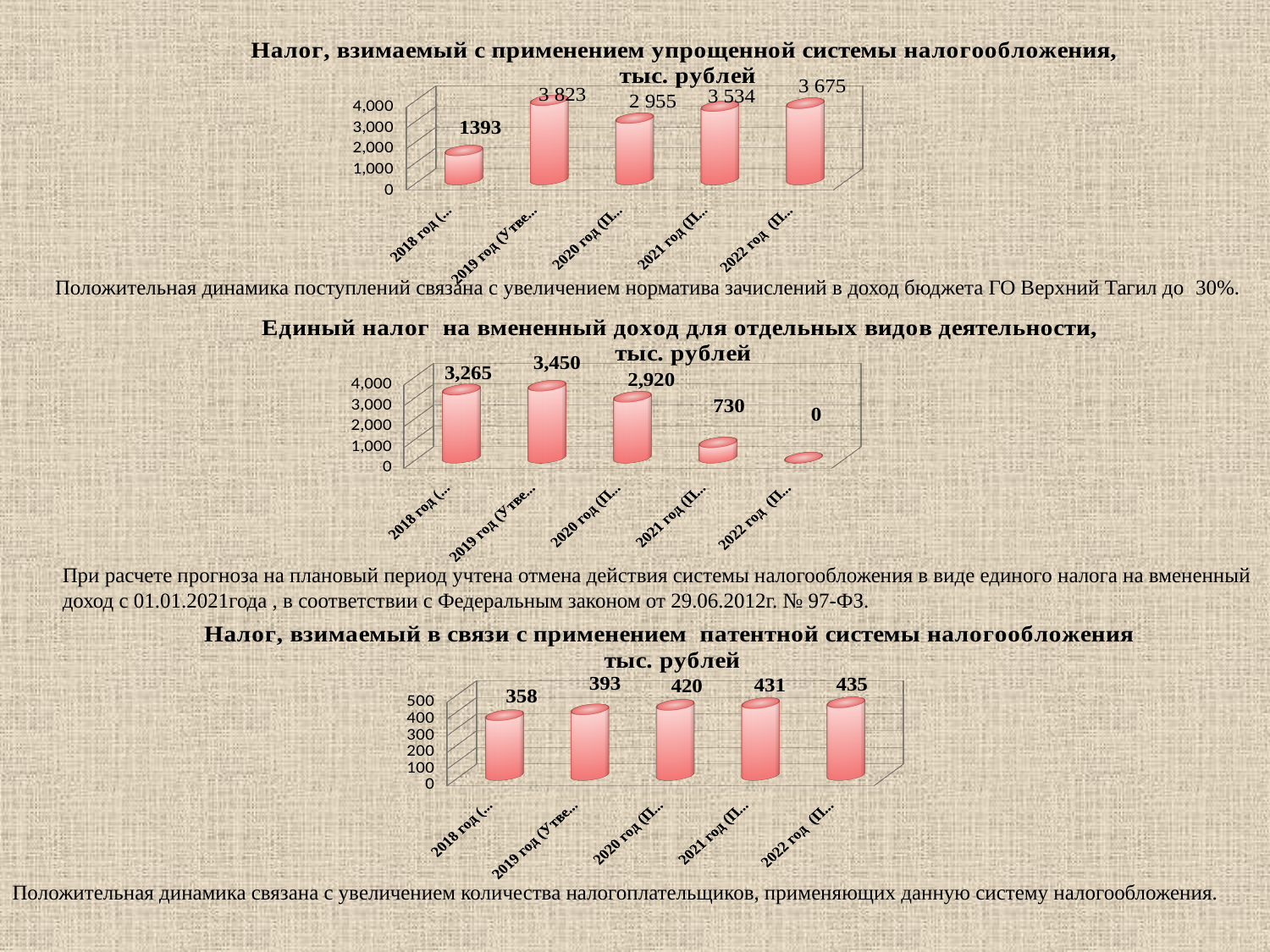
In the bottom chart (патентной системы налогообложения), what is the difference between the values for 2022 год and 2018 год? 77 In the top chart (упрощенной системы налогообложения), which year has the lowest value? 2018 год In the middle chart (Единый налог на вмененный доход), which year has the highest value? 2019 год In the middle chart (Единый налог на вмененный доход), what is the value for 2022 год? 0 In the middle chart (Единый налог на вмененный доход), what is the value for 2021 год? 730 In the top chart (упрощенной системы налогообложения), which year has the highest value? 2019 год In the middle chart (Единый налог на вмененный доход), what is the difference between the values for 2019 год and 2020 год? 530 In the bottom chart (патентной системы налогообложения), what is the value for 2020 год? 420 In the bottom chart (патентной системы налогообложения), do the values rise or fall from 2018 to 2022? rise How many categories (years) are shown in the bottom chart (патентной системы налогообложения)? 5 In the top chart (Налог, взимаемый с применением упрощенной системы налогообложения), what is the value for 2018 год? 1393 In the top chart (упрощенной системы налогообложения), what is the value for 2022 год? 3 675